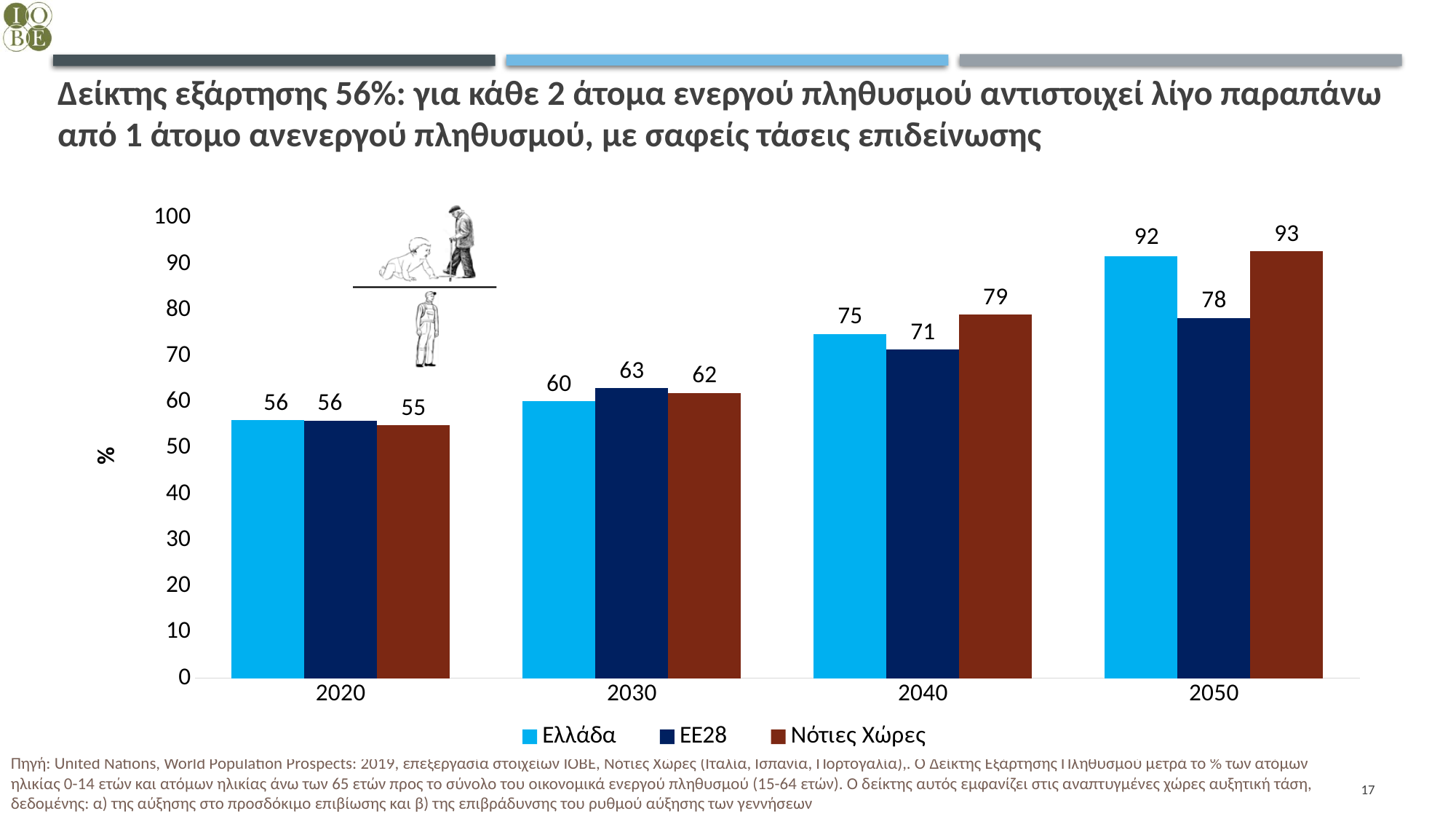
Which is larger in 2040: the value for Ελλάδα or for Νότιες Χώρες? Νότιες Χώρες How many year categories are shown on the x axis? 4 Which series has the highest value in 2030? ΕΕ28 What is the difference between the Νότιες Χώρες value in 2050 and in 2020? 38 What is the value for ΕΕ28 in 2040? 71 What is the label on the vertical axis? % What is the value for Νότιες Χώρες in 2050? 93 Do the values for Ελλάδα rise or fall from 2020 to 2050? rise What kind of chart is shown on the slide? bar chart Which series has the lowest value in 2050? ΕΕ28 How many series does the legend list? 3 What is the value for Ελλάδα in 2020? 56